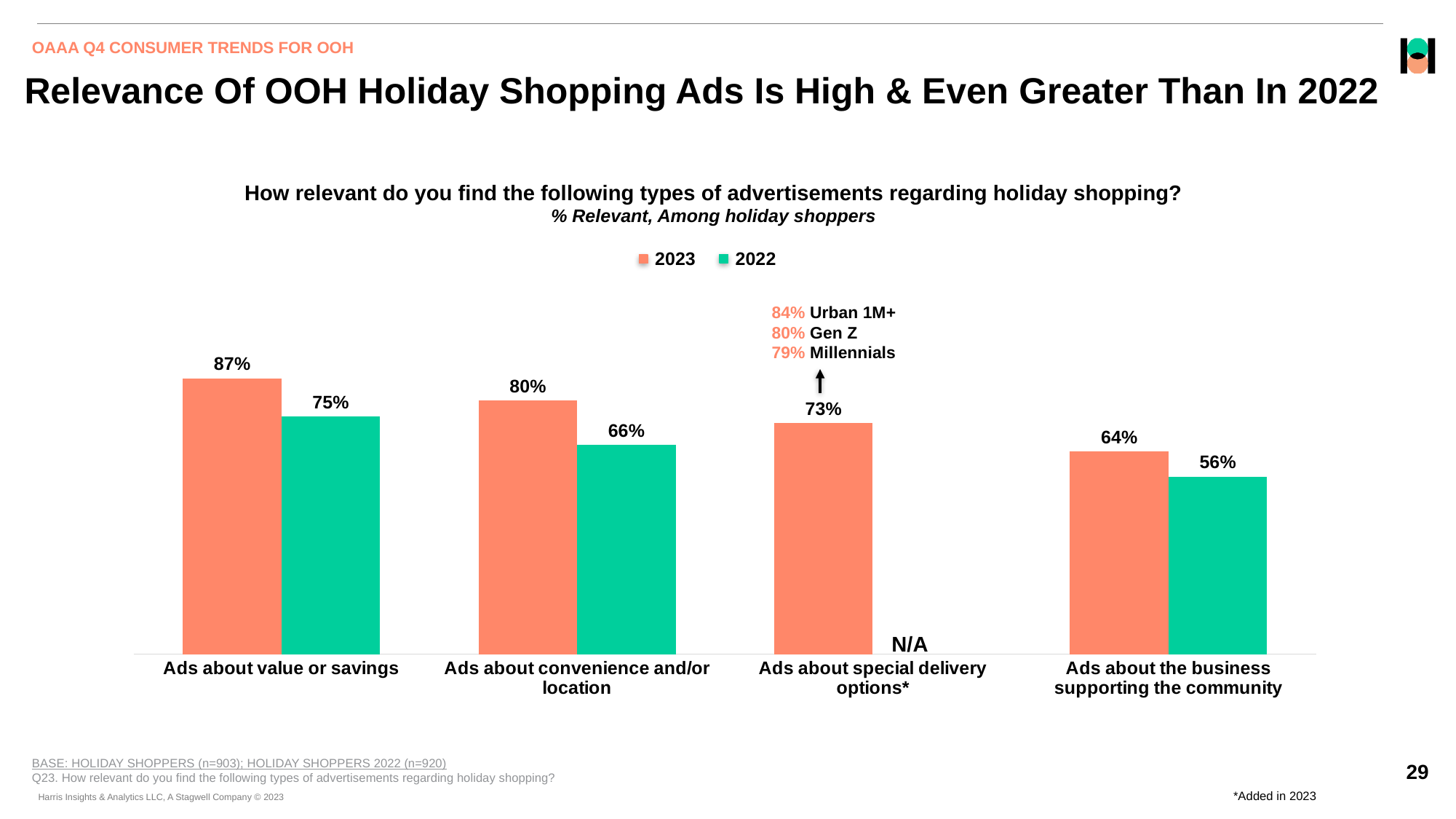
What is the 2023 value for Ads about special delivery options? 73% What kind of chart is shown on the slide? Bar chart What is the 2022 value for Ads about the business supporting the community? 56% How many series does the legend list? 2 How many categories are shown on the x axis? 4 What is the difference between the 2023 and 2022 values for Ads about convenience and/or location? 14% Which category has the highest 2023 value? Ads about value or savings Which category has the lowest 2022 value? Ads about the business supporting the community What is the 2022 value for Ads about convenience and/or location? 66% What is shown for the 2022 value of Ads about special delivery options? N/A What is the 2023 value for Ads about value or savings? 87% Which is larger: the 2023 value for Ads about the business supporting the community or the 2022 value for Ads about value or savings? 2022 value for Ads about value or savings